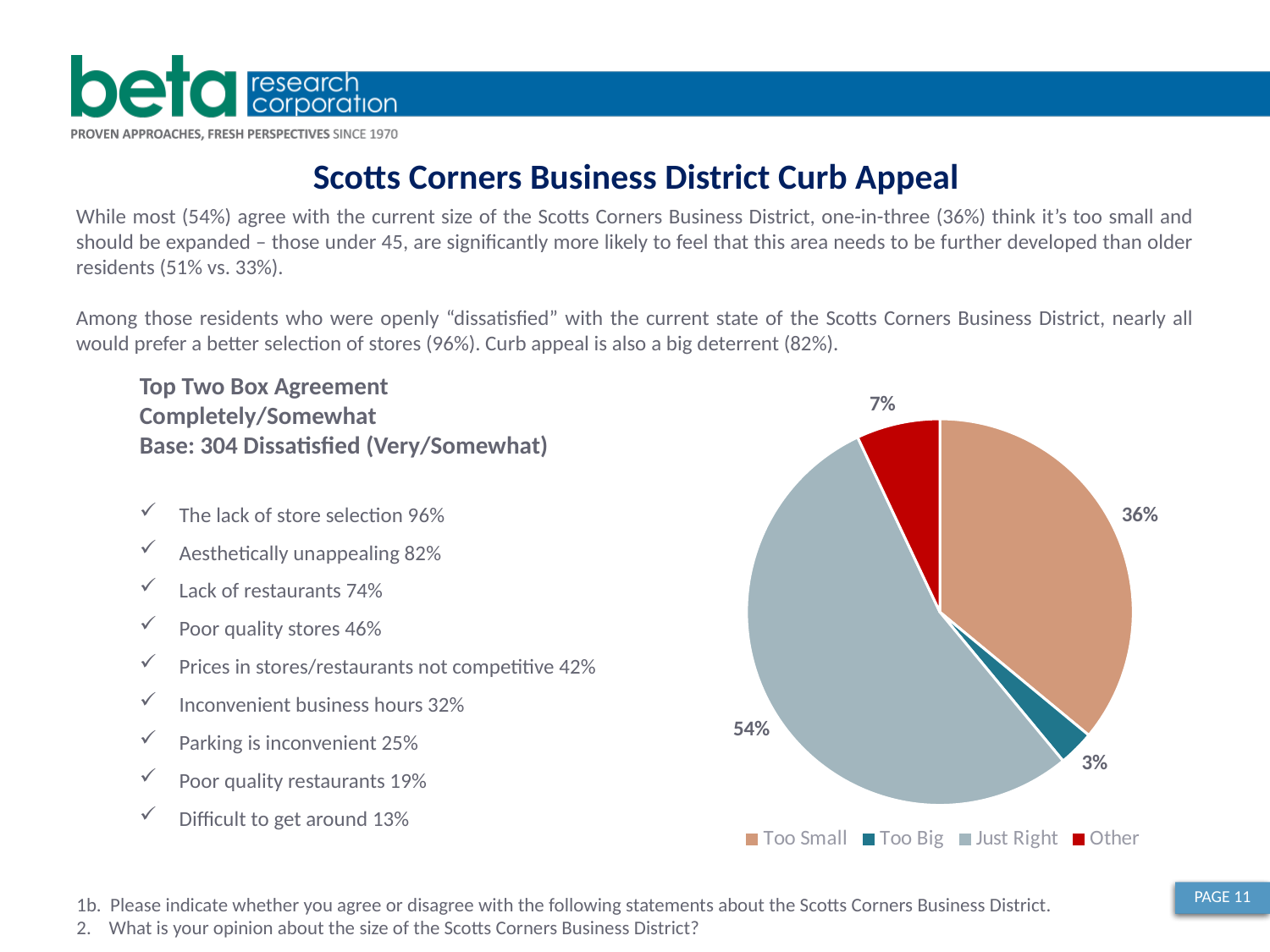
What percentage of the pie chart is labelled "Too Big"? 3% What is the difference in percentage points between the "Just Right" and "Too Small" slices? 18 What type of chart is shown on the slide? Pie chart What percentage of the pie chart is labelled "Other"? 7% Which slice of the pie chart is the largest? Just Right Which slice of the pie chart is the smallest? Too Big What colour is the "Other" slice in the pie chart? Red What percentage of the pie chart is labelled "Just Right"? 54% How many slices does the pie chart have? 4 How many entries does the pie chart legend list? 4 What percentage of the pie chart is labelled "Too Small"? 36% Which is larger in the pie chart, "Other" or "Too Big"? Other